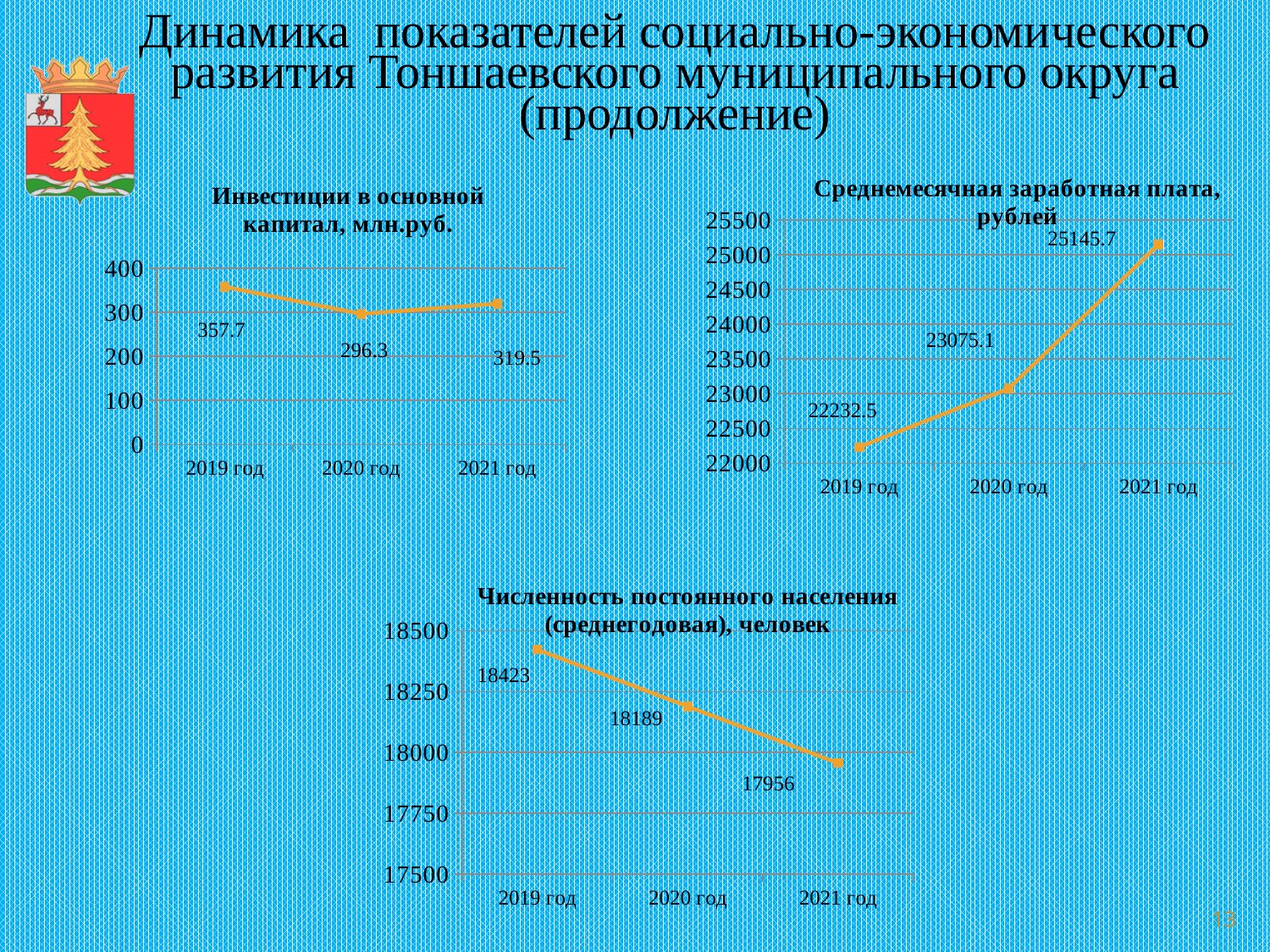
In the chart 'Численность постоянного населения (среднегодовая), человек', which year has the highest value? 2019 год In the chart 'Численность постоянного населения (среднегодовая), человек', what is the difference between the 2019 год and 2021 год values? 467 In the chart 'Среднемесячная заработная плата, рублей', what is the value for 2021 год? 25145.7 In the chart 'Численность постоянного населения (среднегодовая), человек', do the values rise or fall from 2019 год to 2021 год? fall In the chart 'Численность постоянного населения (среднегодовая), человек', what is the value for 2020 год? 18189 In the chart 'Среднемесячная заработная плата, рублей', is the value for 2020 год greater or less than 23000? greater What kind of chart is 'Инвестиции в основной капитал, млн.руб.'? line chart In the chart 'Инвестиции в основной капитал, млн.руб.', what is the difference between the 2019 год and 2020 год values? 61.4 In the chart 'Инвестиции в основной капитал, млн.руб.', what is the value for 2019 год? 357.7 In the chart 'Среднемесячная заработная плата, рублей', what is the difference between the 2021 год and 2019 год values? 2913.2 In the chart 'Инвестиции в основной капитал, млн.руб.', which year has the lowest value? 2020 год In the chart 'Среднемесячная заработная плата, рублей', do the values rise or fall from 2019 год to 2021 год? rise